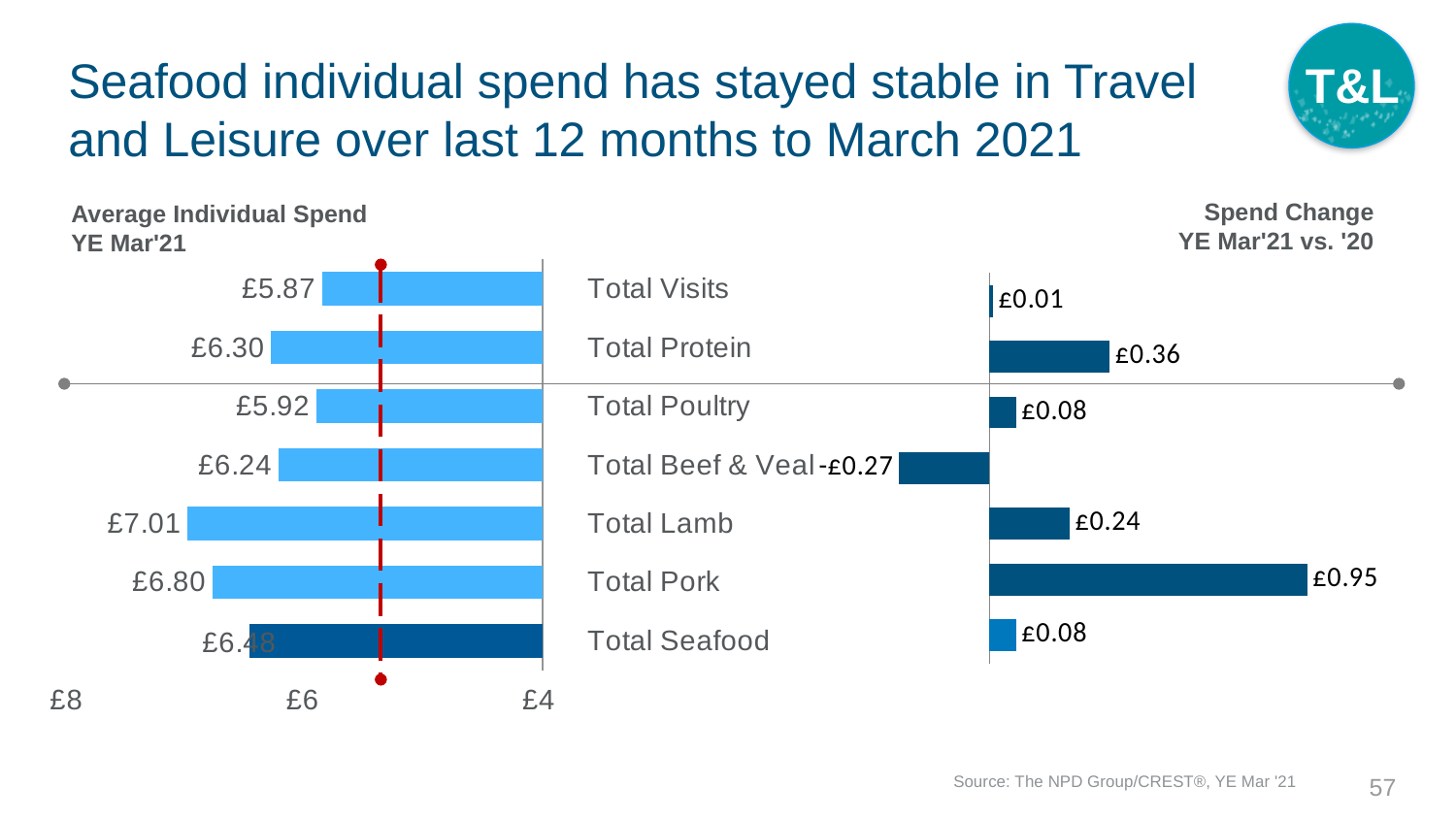
In the Average Individual Spend YE Mar'21 chart, what is the value for Total Lamb? £7.01 In the Average Individual Spend YE Mar'21 chart, what is the value for Total Visits? £5.87 How many categories are shown in the Average Individual Spend YE Mar'21 chart? 7 In the Spend Change YE Mar'21 vs. '20 chart, which category has the lowest value? Total Beef & Veal In the Average Individual Spend YE Mar'21 chart, which category has the lowest value? Total Visits In the Spend Change YE Mar'21 vs. '20 chart, what is the value for Total Pork? £0.95 What kind of chart is the Spend Change YE Mar'21 vs. '20 chart? Bar chart In the Spend Change YE Mar'21 vs. '20 chart, which is larger, Total Protein or Total Lamb? Total Protein In the Average Individual Spend YE Mar'21 chart, is the value for Total Poultry greater or less than £6? less In the Average Individual Spend YE Mar'21 chart, what is the difference between Total Pork and Total Seafood? £0.32 In the Spend Change YE Mar'21 vs. '20 chart, what is the value for Total Beef & Veal? -£0.27 In the Average Individual Spend YE Mar'21 chart, which category has the highest value? Total Lamb